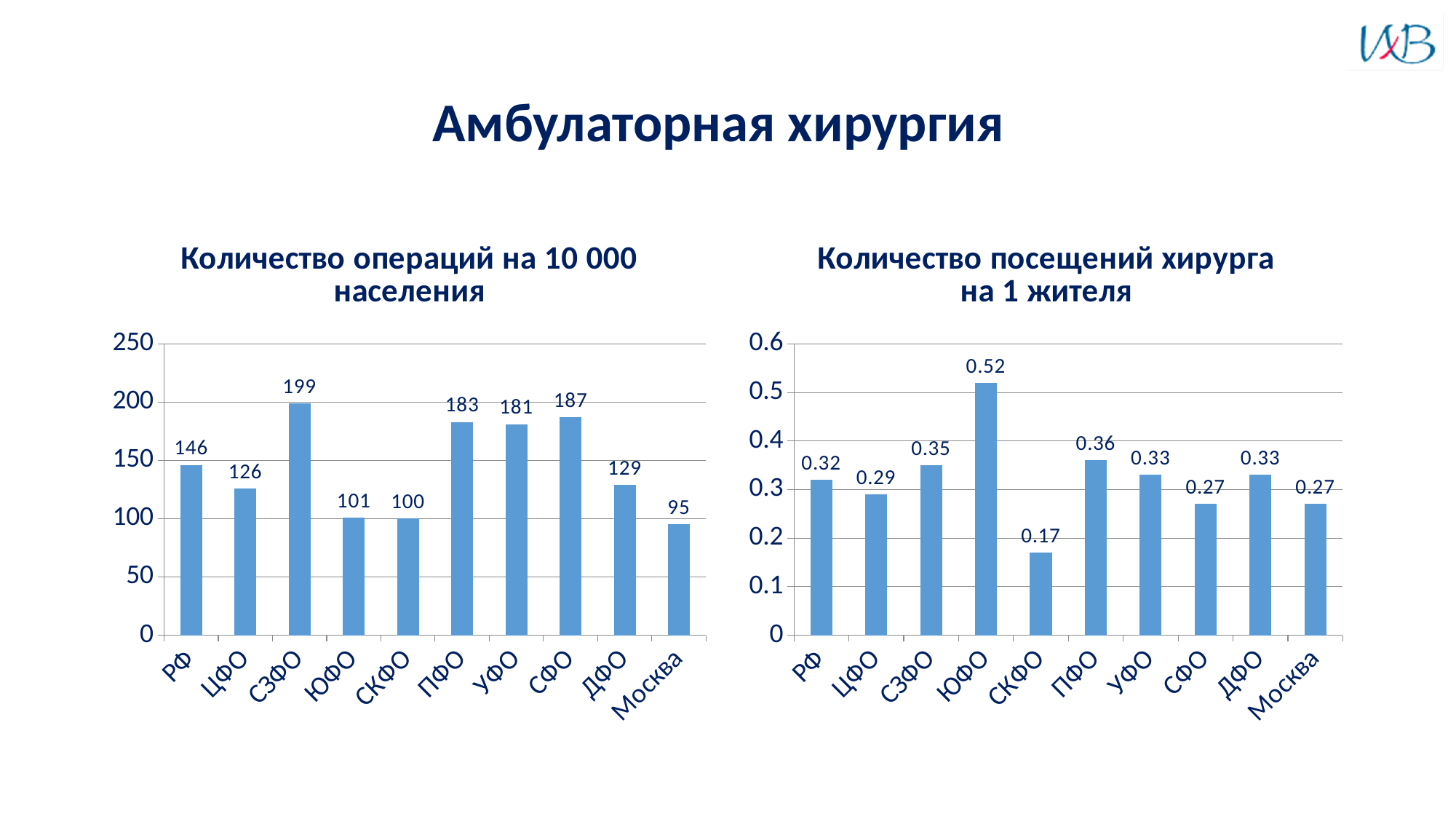
In the left chart 'Количество операций на 10 000 населения', how many categories are shown on the x axis? 10 In the right chart 'Количество посещений хирурга на 1 жителя', which is larger, the value for ПФО or the value for ЦФО? ПФО In the right chart 'Количество посещений хирурга на 1 жителя', what is the difference between the values for ЮФО and СКФО? 0.35 In the left chart 'Количество операций на 10 000 населения', which category has the lowest value? Москва In the left chart 'Количество операций на 10 000 населения', what is the difference between the values for ПФО and ЦФО? 57 In the right chart 'Количество посещений хирурга на 1 жителя', which category has the lowest value? СКФО In the right chart 'Количество посещений хирурга на 1 жителя', what is the value for РФ? 0.32 In the left chart 'Количество операций на 10 000 населения', is the value for ДФО greater or less than 150? less What kind of chart is the left chart 'Количество операций на 10 000 населения'? Bar chart In the left chart 'Количество операций на 10 000 населения', what is the value for СЗФО? 199 In the left chart 'Количество операций на 10 000 населения', which category has the highest value? СЗФО In the right chart 'Количество посещений хирурга на 1 жителя', what is the value for ЮФО? 0.52